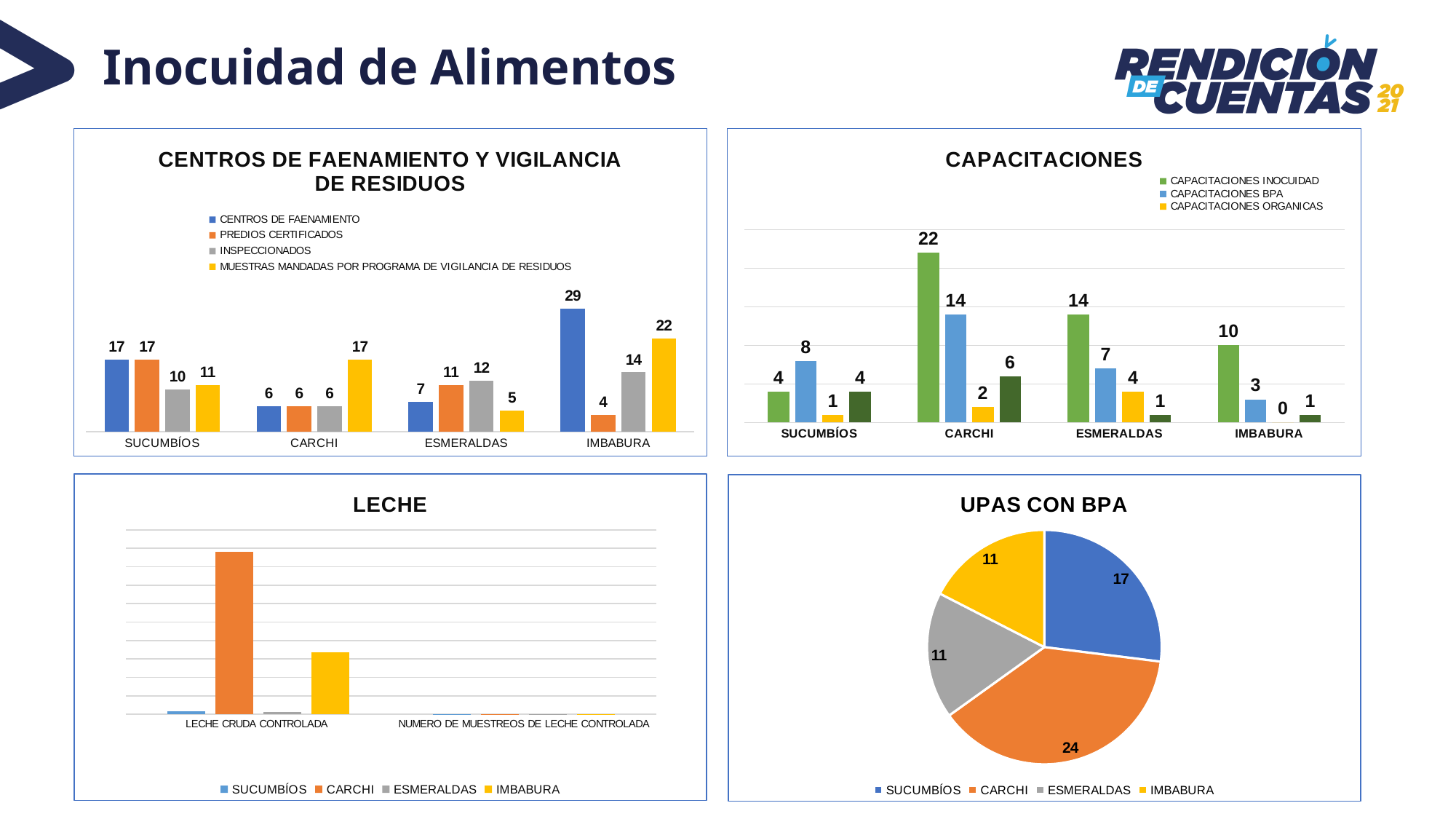
In the CENTROS DE FAENAMIENTO Y VIGILANCIA DE RESIDUOS chart, what is the value of MUESTRAS MANDADAS POR PROGRAMA DE VIGILANCIA DE RESIDUOS for CARCHI? 17 How many series does the legend of the CAPACITACIONES chart list? 3 In the CAPACITACIONES chart, which province has the lowest value for CAPACITACIONES BPA? IMBABURA In the LECHE chart, which province has the highest bar for LECHE CRUDA CONTROLADA? CARCHI In the CAPACITACIONES chart, what is the value of CAPACITACIONES INOCUIDAD for CARCHI? 22 In the CENTROS DE FAENAMIENTO Y VIGILANCIA DE RESIDUOS chart, what is the value of CENTROS DE FAENAMIENTO for IMBABURA? 29 In the UPAS CON BPA pie chart, what is the value for CARCHI? 24 What kind of chart is the LECHE chart? bar chart In the CENTROS DE FAENAMIENTO Y VIGILANCIA DE RESIDUOS chart, what is the difference between INSPECCIONADOS for IMBABURA and for SUCUMBÍOS? 4 In the CENTROS DE FAENAMIENTO Y VIGILANCIA DE RESIDUOS chart, which province has the highest value for CENTROS DE FAENAMIENTO? IMBABURA In the CAPACITACIONES chart, is CAPACITACIONES INOCUIDAD for ESMERALDAS larger or smaller than CAPACITACIONES BPA for SUCUMBÍOS? larger In the UPAS CON BPA pie chart, what is the difference between the values for CARCHI and SUCUMBÍOS? 7